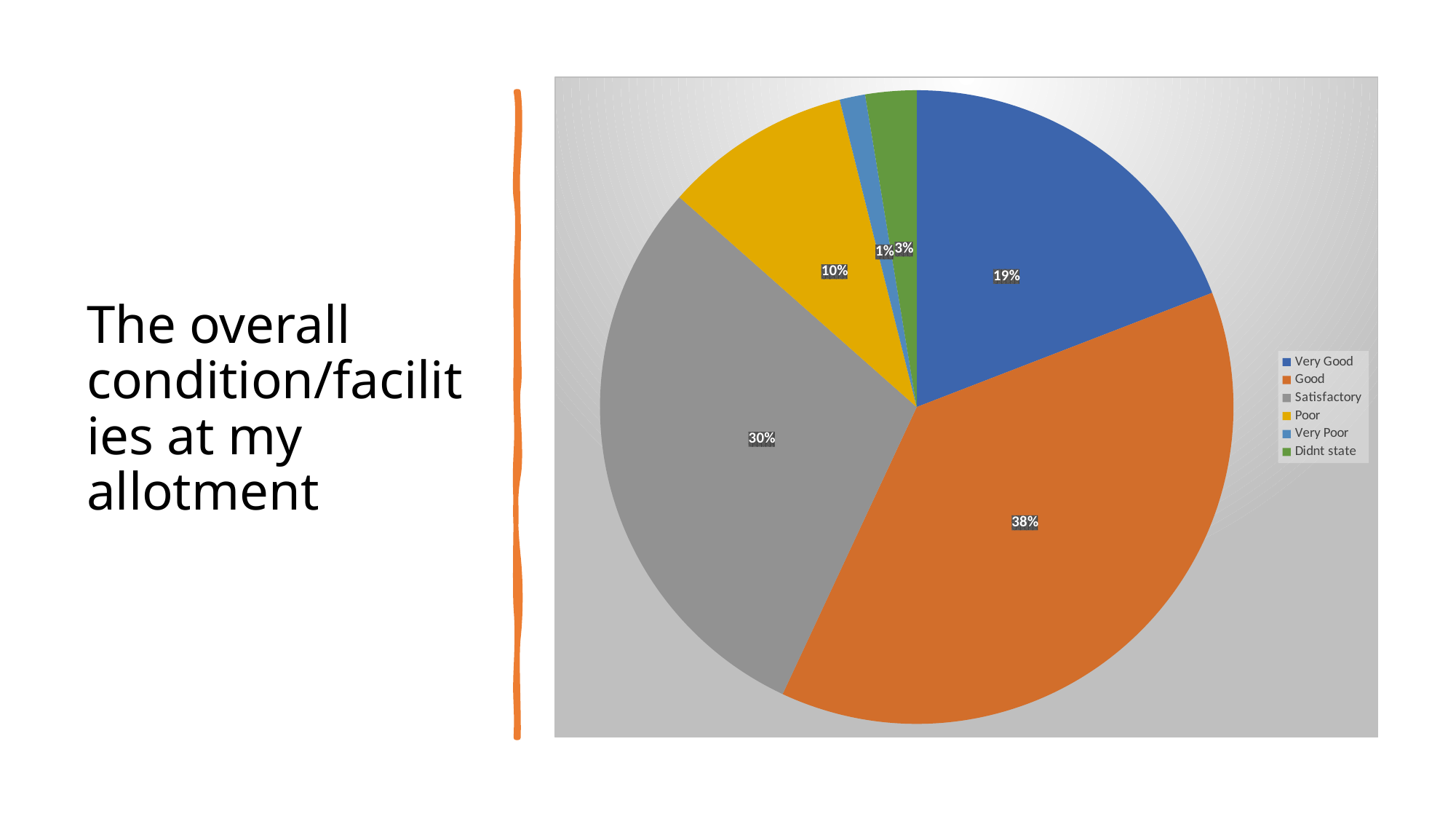
Which category has the smallest share of the pie? Very Poor What percentage of respondents rated the overall condition/facilities at their allotment as Good? 38% What kind of chart is shown on the slide? Pie chart What percentage is shown for the Poor slice? 10% How many categories does the legend list? 6 Which category has the largest share of the pie? Good What is the difference in percentage points between the Good and Satisfactory slices? 8 What percentage is shown for the Very Good slice? 19% Which colour represents the Didnt state category in the pie chart? Green What percentage is shown for the Satisfactory slice? 30% What percentage is shown for the Very Poor slice? 1% Which is larger, the Very Good slice or the Poor slice? Very Good